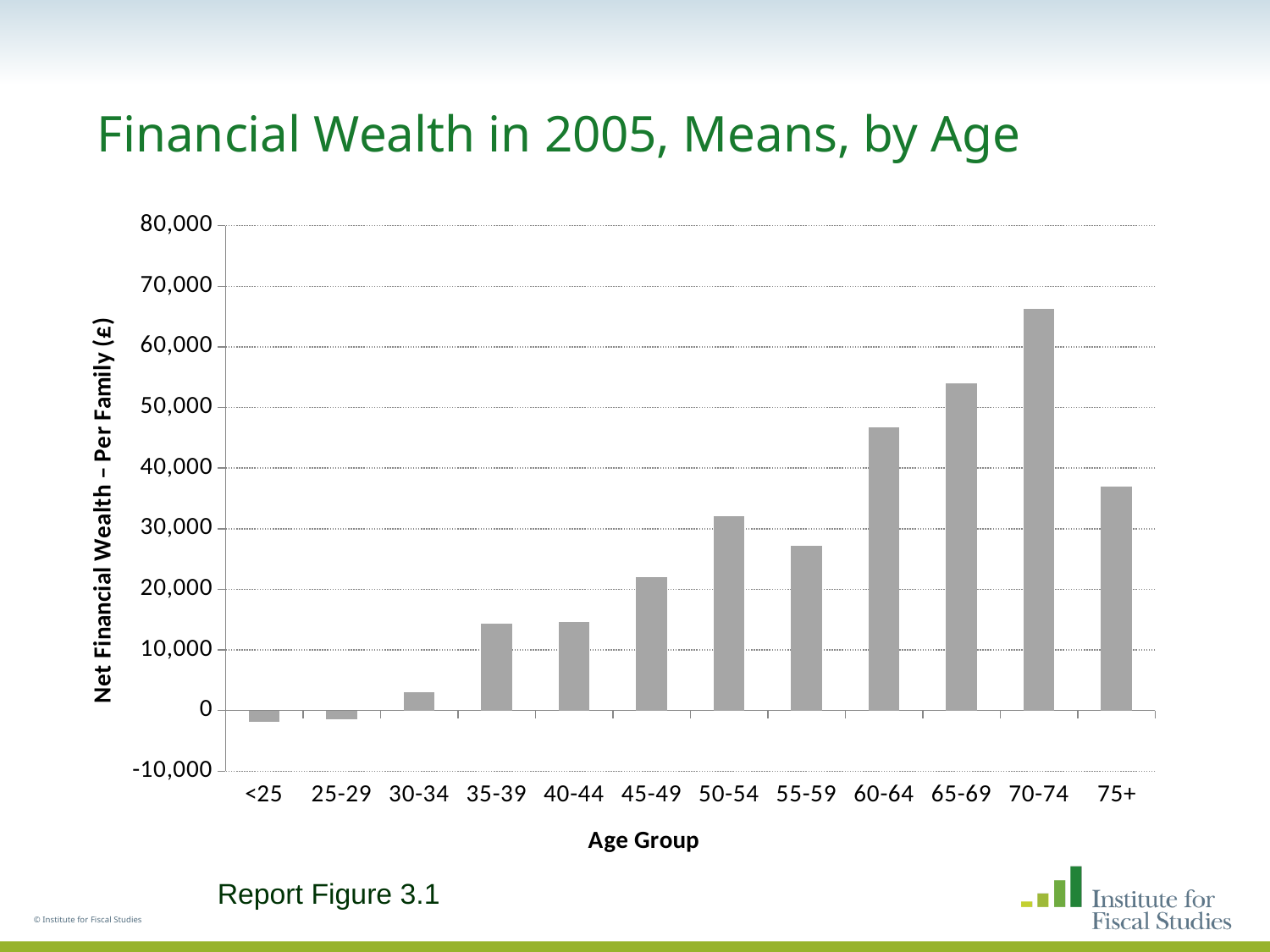
Which has the larger net financial wealth, the 50-54 age group or the 55-59 age group? 50-54 Is the value for the 70-74 age group greater or less than 60,000? greater What kind of chart is shown on the slide? bar chart What is the label of the y axis? Net Financial Wealth – Per Family (£) Is the value for the 65-69 age group greater or less than 50,000? greater Is the value for the 75+ age group greater or less than 40,000? less Which age group has the highest net financial wealth? 70-74 How many age groups are shown on the x axis? 12 Do the values generally rise or fall from the <25 age group to the 70-74 age group? rise